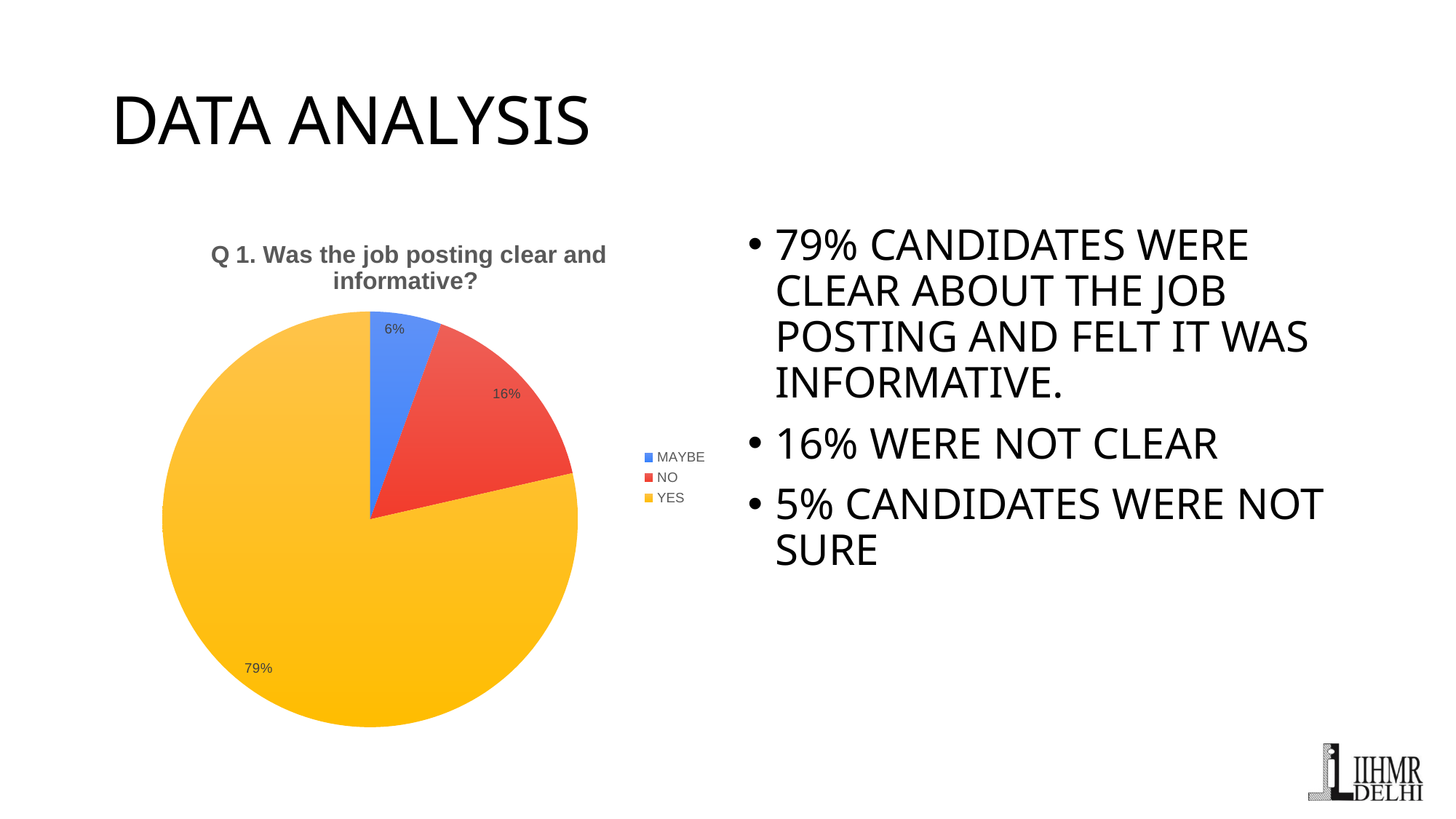
Which slice is larger, NO or MAYBE? NO How many categories does the legend list? 3 What is the difference in percentage points between the NO and MAYBE slices? 10 What is the title of the chart? Q 1. Was the job posting clear and informative? Which category has the smallest share of the pie? MAYBE What percentage of the pie is the YES slice? 79% What colour is the YES slice? Yellow Which category has the largest share of the pie? YES What type of chart is shown on the slide? Pie chart What is the difference in percentage points between the YES and NO slices? 63 What percentage of the pie is the MAYBE slice? 6% What percentage of the pie is the NO slice? 16%